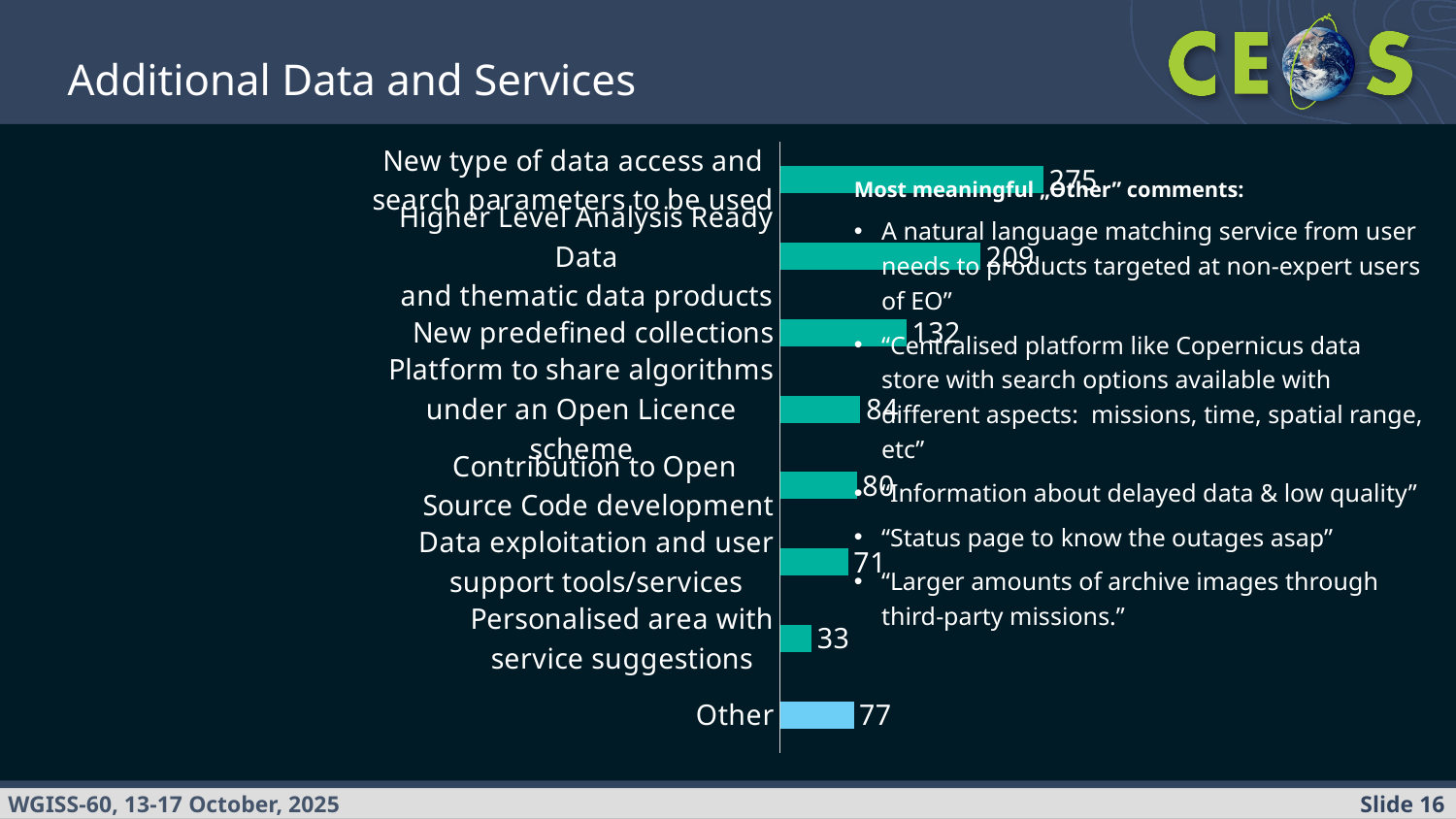
What is the difference between the values for "New type of data access and search parameters to be used" and "Higher Level Analysis Ready Data and thematic data products"? 66 What is the value for "Other"? 77 What is the value for "Personalised area with service suggestions"? 33 Which category has the highest value? New type of data access and search parameters to be used How many categories are shown in the chart? 8 Which is larger: the value for "Other" or the value for "Data exploitation and user support tools/services"? Other What is the value for "Contribution to Open Source Code development"? 80 What kind of chart is shown on the slide? Bar chart Which category has the lowest value? Personalised area with service suggestions What is the difference between the values for "New predefined collections" and "Other"? 55 What is the value for "New predefined collections"? 132 What is the value for "Data exploitation and user support tools/services"? 71